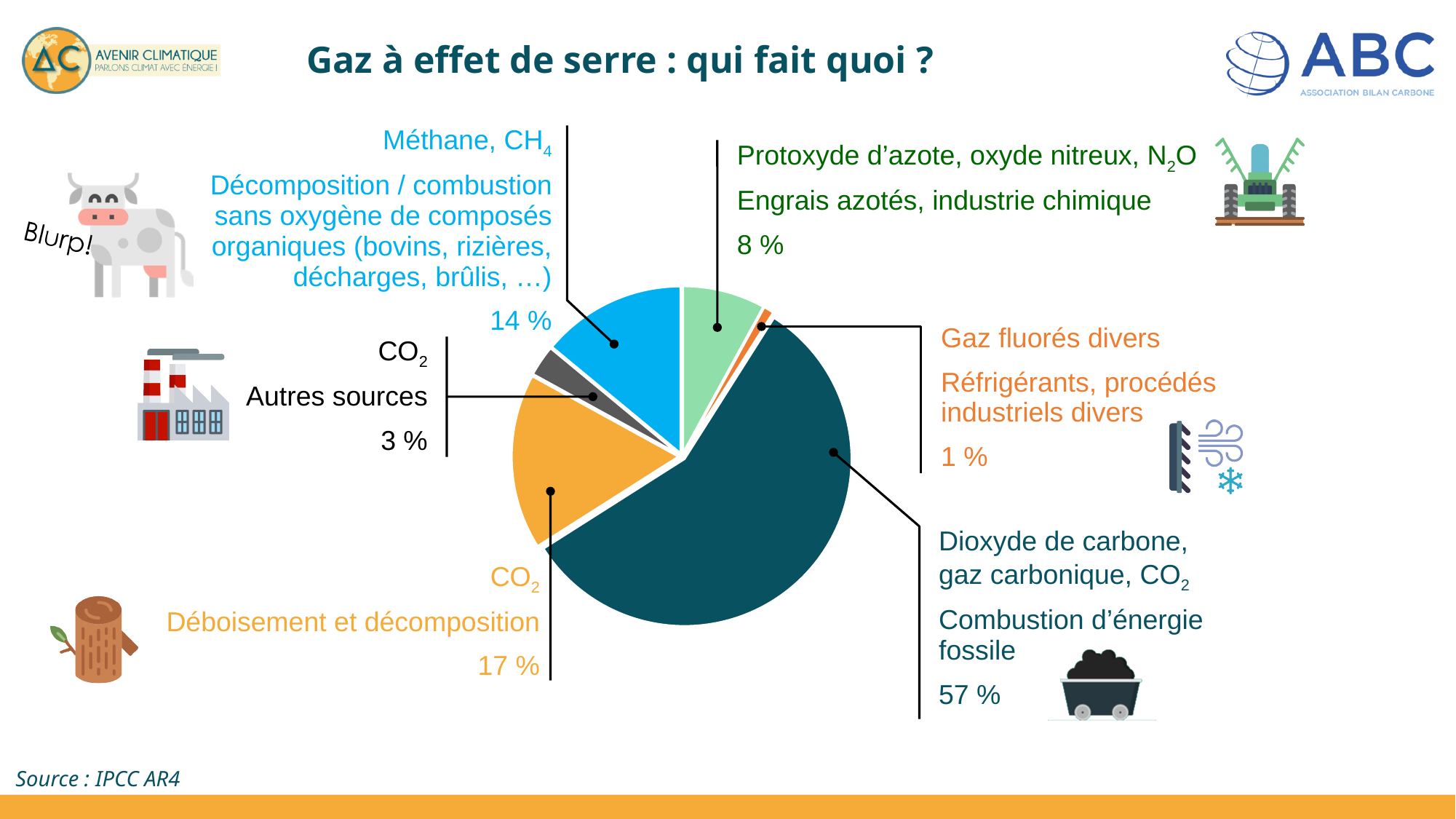
What share of the pie is attributed to Méthane, CH4? 14 % Which slice of the pie is the smallest? Gaz fluorés divers What is the difference between the share for CO2 from déboisement et décomposition and the share for Méthane, CH4? 3 % What share of the pie is attributed to Protoxyde d'azote, N2O? 8 % What share of the pie is attributed to Gaz fluorés divers? 1 % What share of the pie is attributed to CO2 from combustion d'énergie fossile? 57 % Which slice of the pie is the largest? Combustion d'énergie fossile (CO2) What kind of chart is shown on the slide? pie chart How many slices does the pie chart have? 6 Which is larger: the share for Protoxyde d'azote, N2O or the share for Méthane, CH4? Méthane, CH4 What share of the pie is attributed to CO2 from déboisement et décomposition? 17 % What share of the pie is attributed to CO2 from autres sources? 3 %